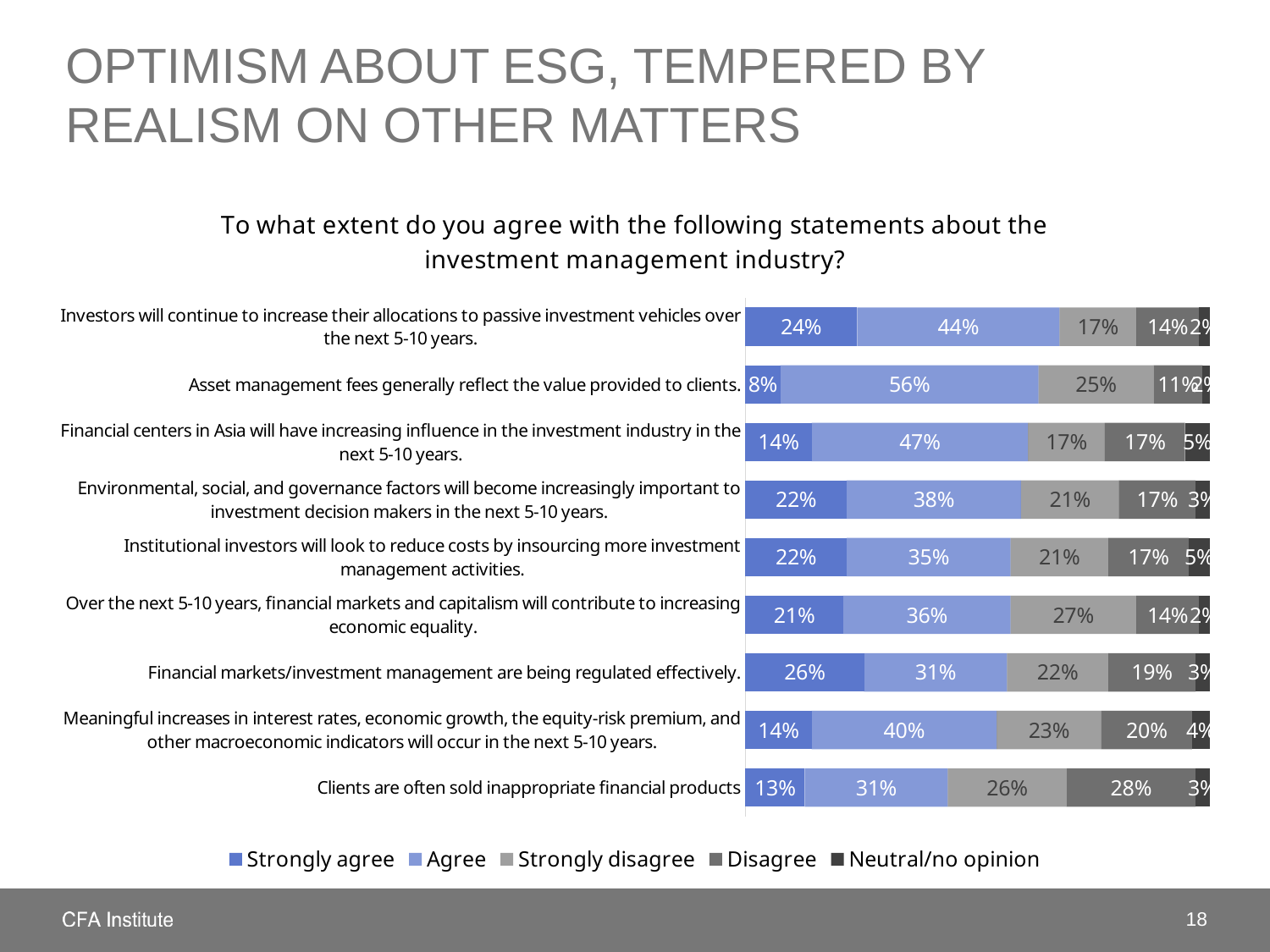
Which statement has the highest Agree percentage? Asset management fees generally reflect the value provided to clients. What is the Agree value for the statement that financial centers in Asia will have increasing influence in the investment industry in the next 5-10 years? 47% What percentage of respondents chose Disagree for the statement that clients are often sold inappropriate financial products? 28% Which is larger: the Strongly agree percentage for the ESG statement or the Strongly agree percentage for the statement that financial markets/investment management are being regulated effectively? Financial markets/investment management are being regulated effectively. How many series does the legend list? 5 What is the difference between the Agree percentage for the passive investment vehicles statement and the Agree percentage for the statement that financial markets/investment management are being regulated effectively? 13% What percentage of respondents strongly agree that asset management fees generally reflect the value provided to clients? 8% How many statements are shown in the chart? 9 Which statement has the lowest Strongly agree percentage? Asset management fees generally reflect the value provided to clients. What is the combined Strongly agree and Agree percentage for the statement that investors will continue to increase their allocations to passive investment vehicles over the next 5-10 years? 68% What type of chart is shown on the slide? Stacked bar chart What is the last entry listed in the chart legend? Neutral/no opinion